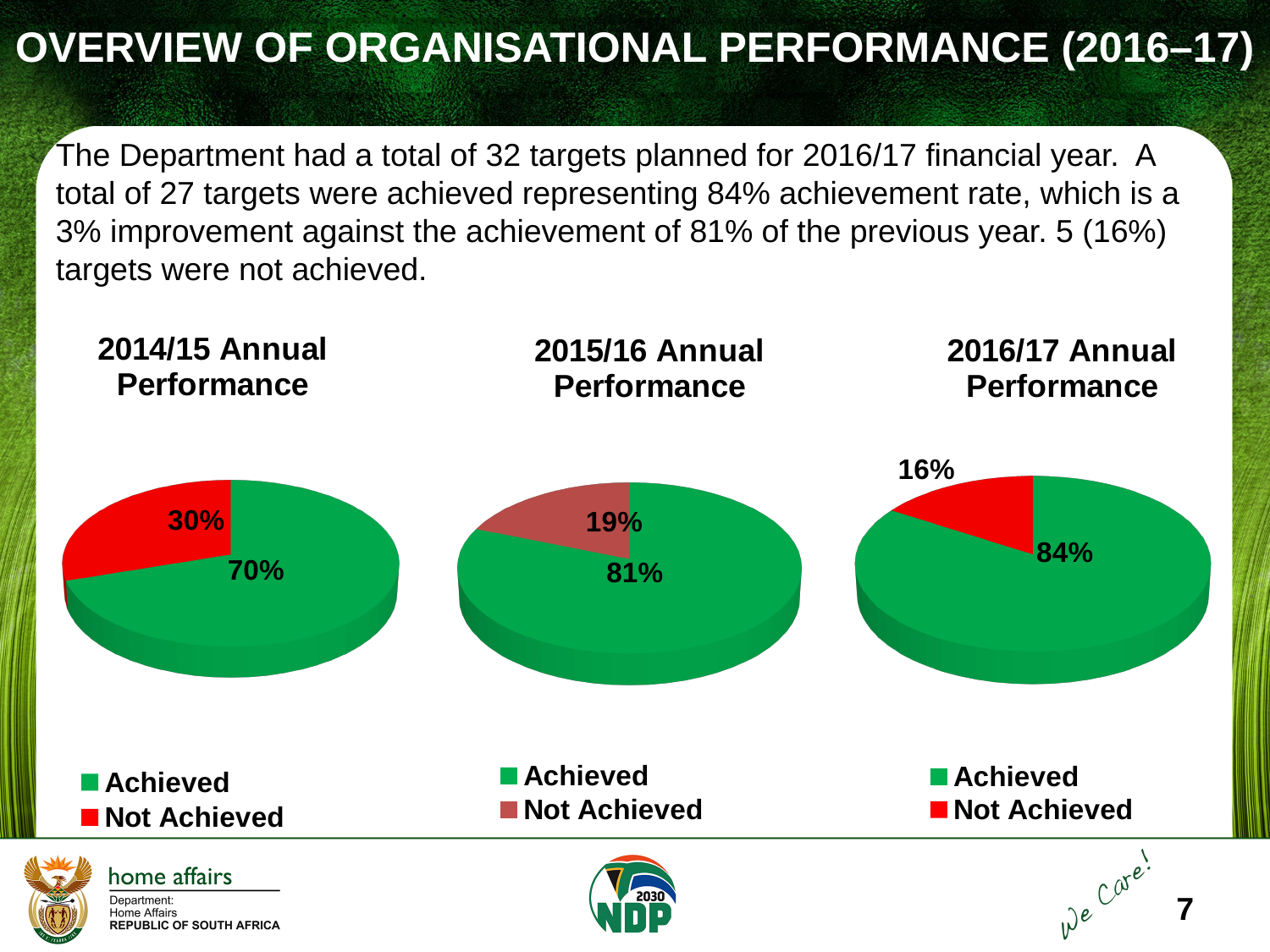
In the 2016/17 Annual Performance chart, what share of targets was Achieved? 84% In the 2015/16 Annual Performance chart, what share of targets was Achieved? 81% In the 2015/16 Annual Performance chart, what share of targets was Not Achieved? 19% In the 2016/17 Annual Performance chart, what share of targets was Not Achieved? 16% In the 2014/15 Annual Performance chart, what is the difference between the Achieved and Not Achieved shares? 40% In the 2014/15 Annual Performance chart, what share of targets was Not Achieved? 30% What kind of chart is the 2016/17 Annual Performance chart? Pie chart In the 2015/16 Annual Performance chart, what colour is the Achieved slice? Green In the 2016/17 Annual Performance chart, which slice is larger, Achieved or Not Achieved? Achieved How many entries does the legend of the 2016/17 Annual Performance chart list? 2 In the 2014/15 Annual Performance chart, what share of targets was Achieved? 70% How many slices does the 2015/16 Annual Performance pie chart have? 2